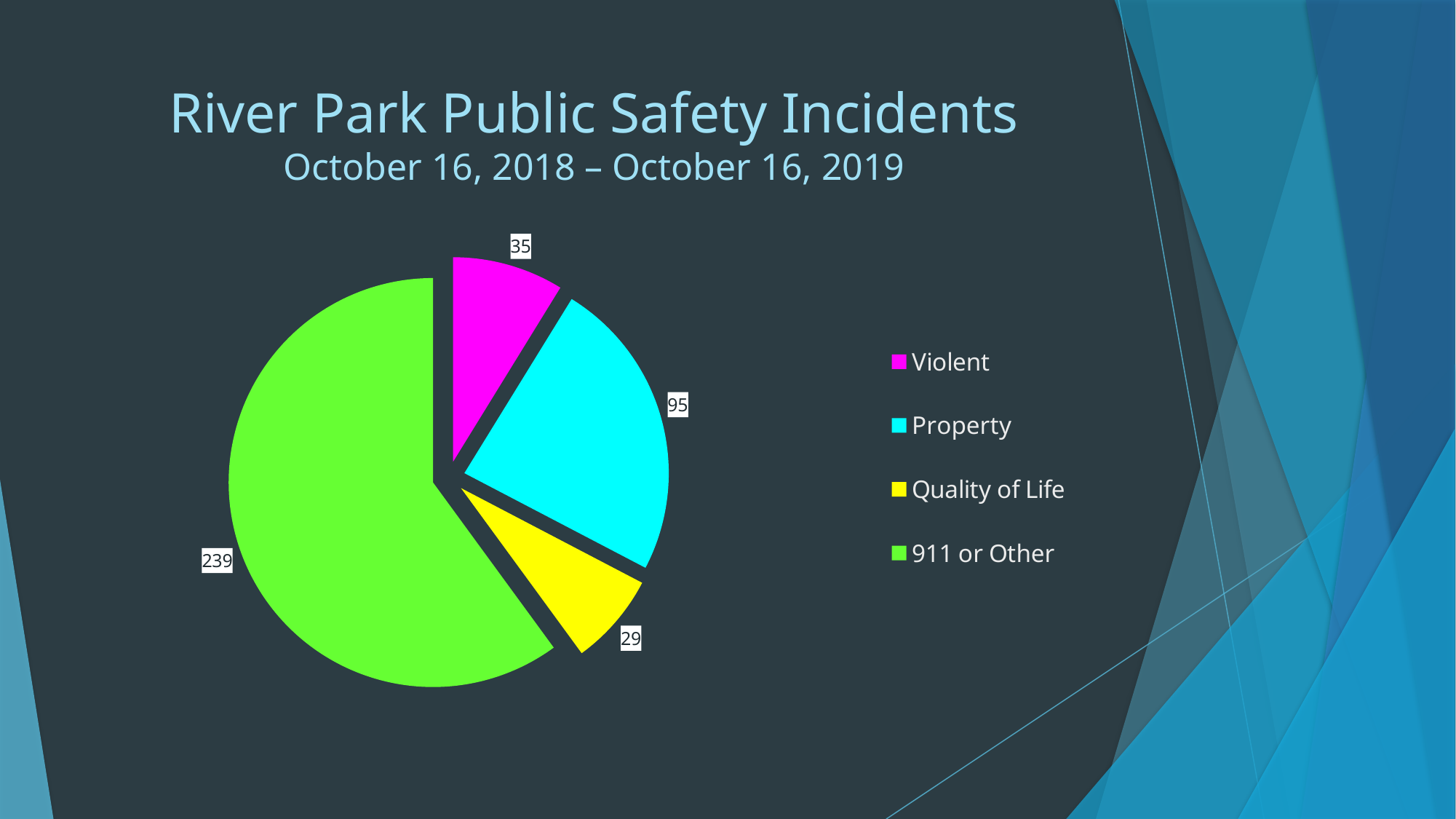
To the nearest whole percent, what share of all incidents does the 911 or Other slice represent? 60% What kind of chart is shown on the slide? Pie chart What is the total number of incidents across all four slices? 398 How many incidents are shown for the Property category? 95 What is the value for Quality of Life? 29 How many Violent incidents are shown on the pie chart? 35 What is the difference between the Property and Violent values? 60 What is the value of the 911 or Other slice? 239 How many categories does the pie chart show? 4 Which category has the largest slice of the pie? 911 or Other Which is larger, the Violent slice or the Quality of Life slice? Violent Which category has the smallest slice of the pie? Quality of Life